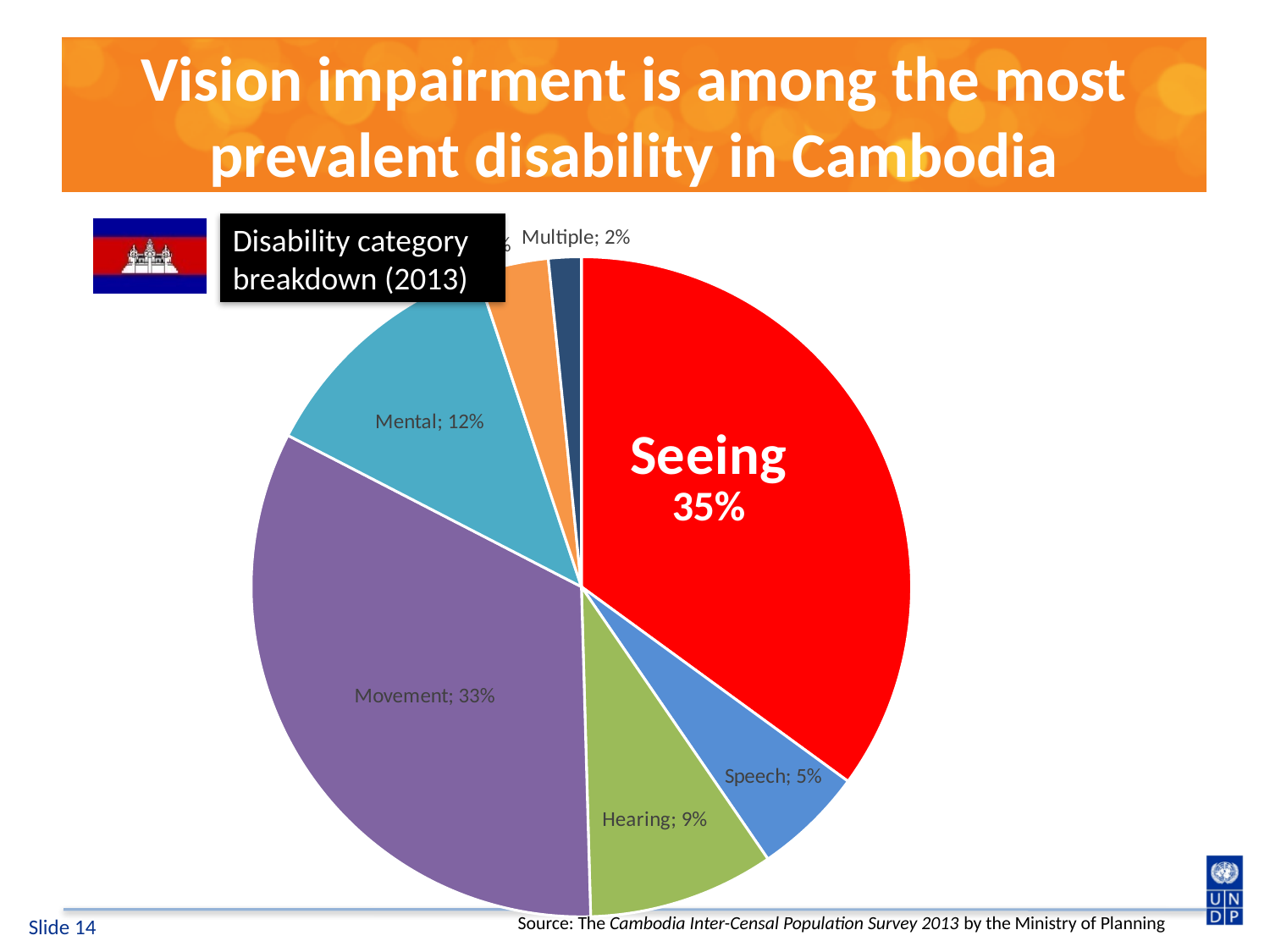
What is the difference in percentage points between the Seeing and Movement slices? 2 What is the value shown for the Speech slice? 5% What percentage does the Movement slice represent? 33% Which is larger, the Hearing slice or the Speech slice? Hearing What is the value shown for the Hearing slice? 9% What colour is the Movement slice? Purple Which labelled disability category has the smallest slice of the pie? Multiple What is the value shown for the Multiple slice? 2% Which disability category has the largest slice of the pie? Seeing What kind of chart is shown on the slide? Pie chart What is the value shown for the Mental slice? 12% What percentage of the pie chart is the Seeing slice? 35%